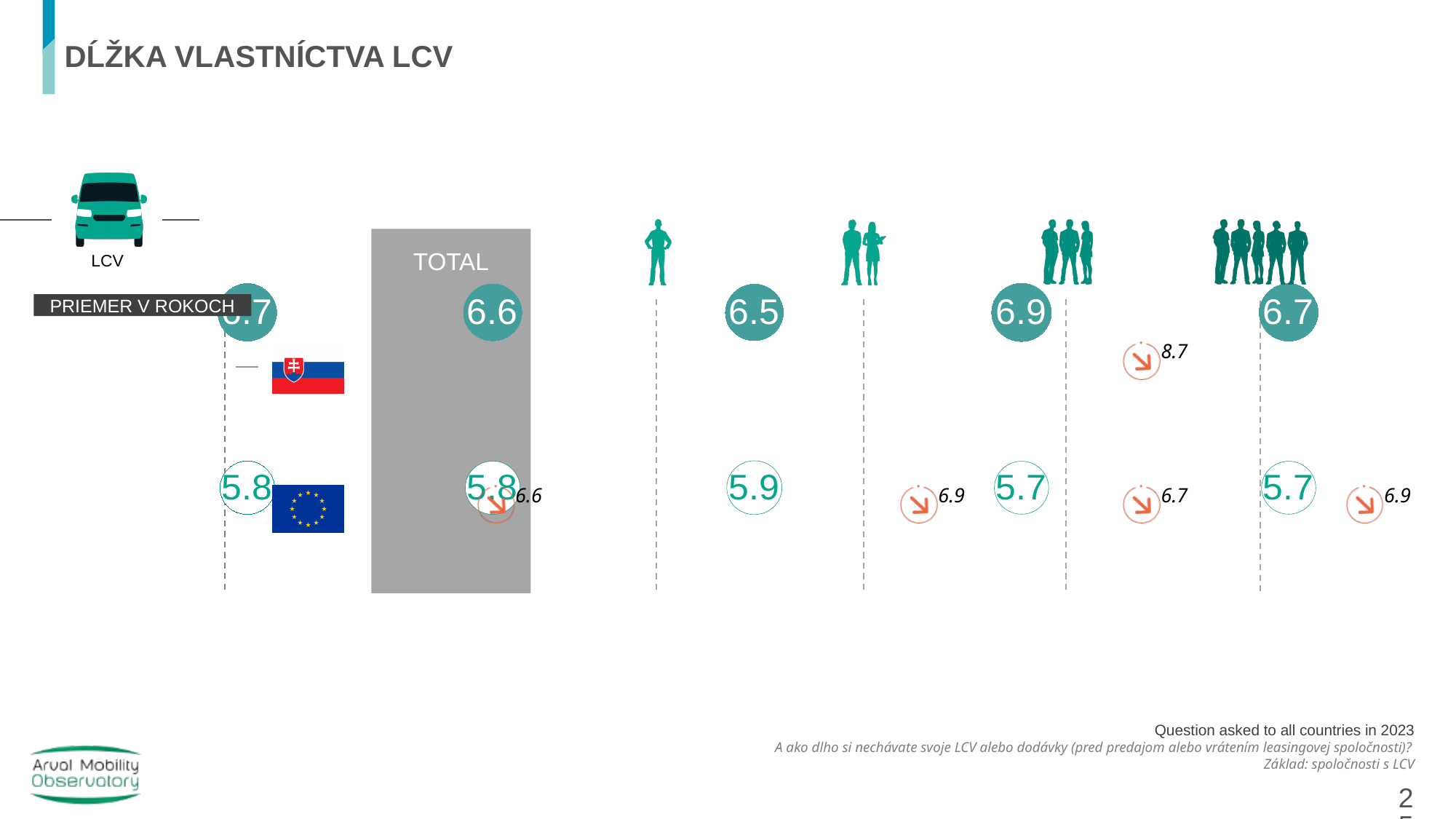
What is the value shown in the TOTAL column for the top row (Slovak flag row)? 6.6 What is the value shown in the TOTAL column for the bottom row (EU flag row)? 5.8 What is the difference between the TOTAL value in the top row (6.6) and the TOTAL value in the bottom row (5.8)? 0.8 What is the title of the slide? DĹŽKA VLASTNÍCTVA LCV What previous value is shown next to the orange arrow in the upper part of the three-person icon column? 8.7 What previous value is shown next to the orange arrow beside the TOTAL value in the bottom row (EU flag row)? 6.6